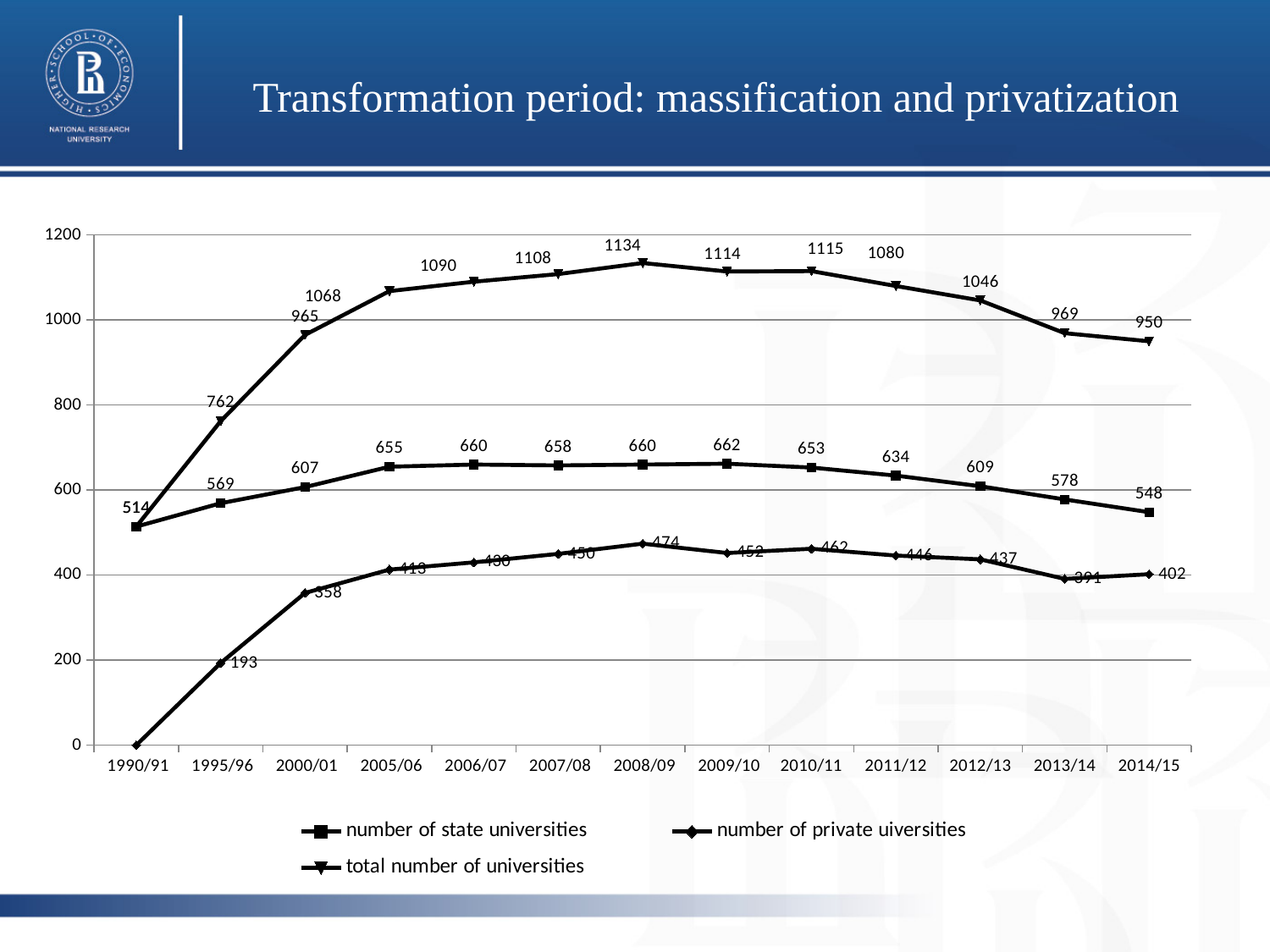
What kind of chart is shown on the slide? line chart What is the number of private universities in 2008/09? 474 Is the number of private universities in 1990/91 greater or less than 200? less In which year is the total number of universities highest? 2008/09 What is the number of state universities in 2014/15? 548 What is the difference between the total number of universities and the number of state universities in 2014/15? 402 How many academic years are shown on the x axis? 13 By how much did the total number of universities fall from 2008/09 to 2014/15? 184 What is the total number of universities in 2008/09? 1134 How many series does the legend list? 3 Which is larger in 1995/96: the number of state universities or the total number of universities? total number of universities In which year is the number of state universities lowest? 1990/91